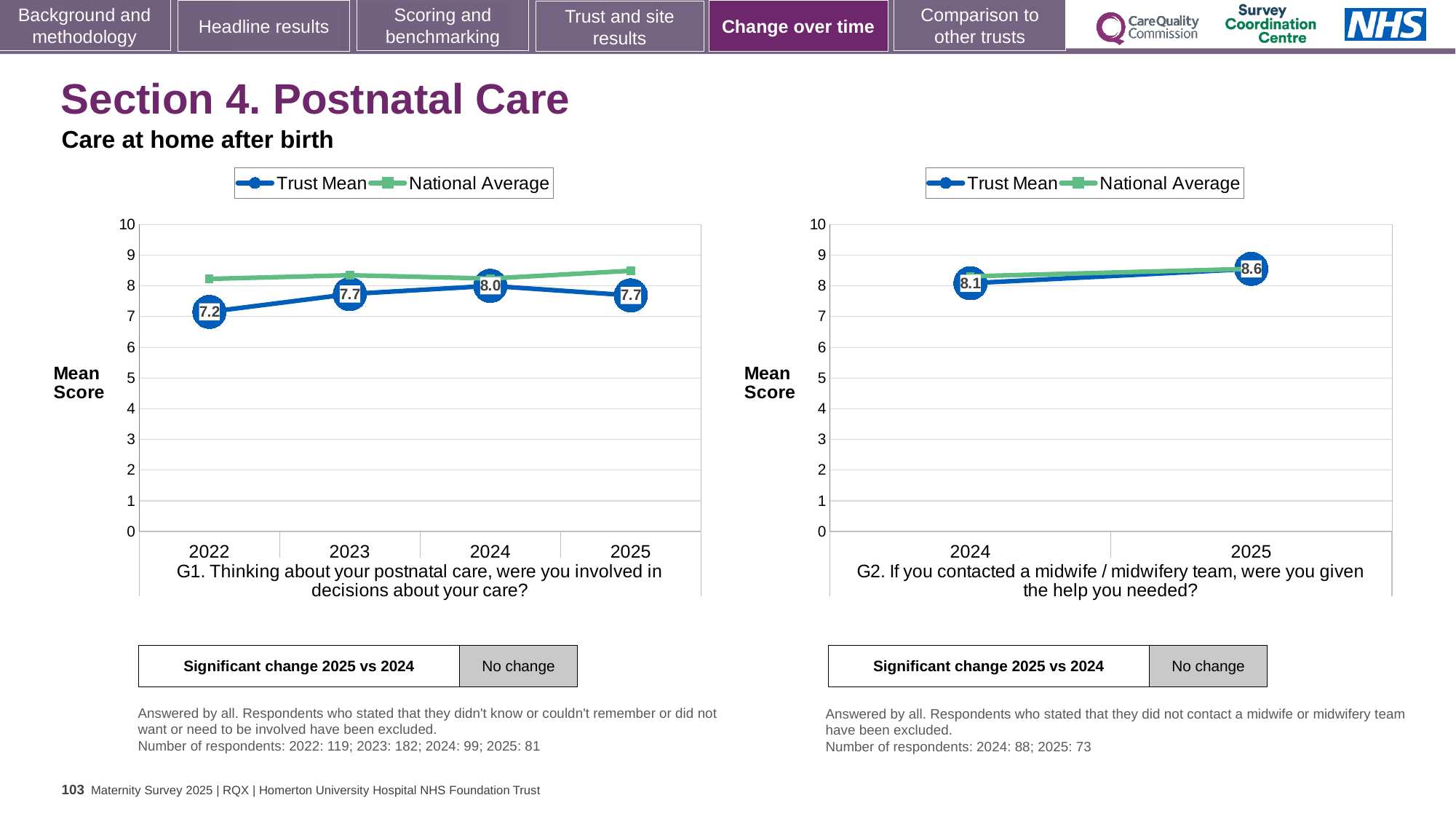
In the right chart (G2), what is the difference between the Trust Mean for 2025 and 2024? 0.5 In the left chart (G1), which year has the highest Trust Mean? 2024 What kind of chart is the right chart (G2)? Line chart In the left chart (G1), which year has the lowest Trust Mean? 2022 In the left chart (G1), what is the Trust Mean for 2022? 7.2 In the left chart (G1), is the National Average for 2025 greater or less than 8? greater How many years are shown on the x axis of the right chart (G2)? 2 How many series does the legend of the left chart (G1) list? 2 In the left chart (G1), is the Trust Mean for 2023 greater or less than the Trust Mean for 2022? greater In the left chart (G1), what is the difference between the Trust Mean for 2024 and 2022? 0.8 In the left chart (G1), what is the Trust Mean for 2024? 8.0 In the right chart (G2), what is the Trust Mean for 2025? 8.6